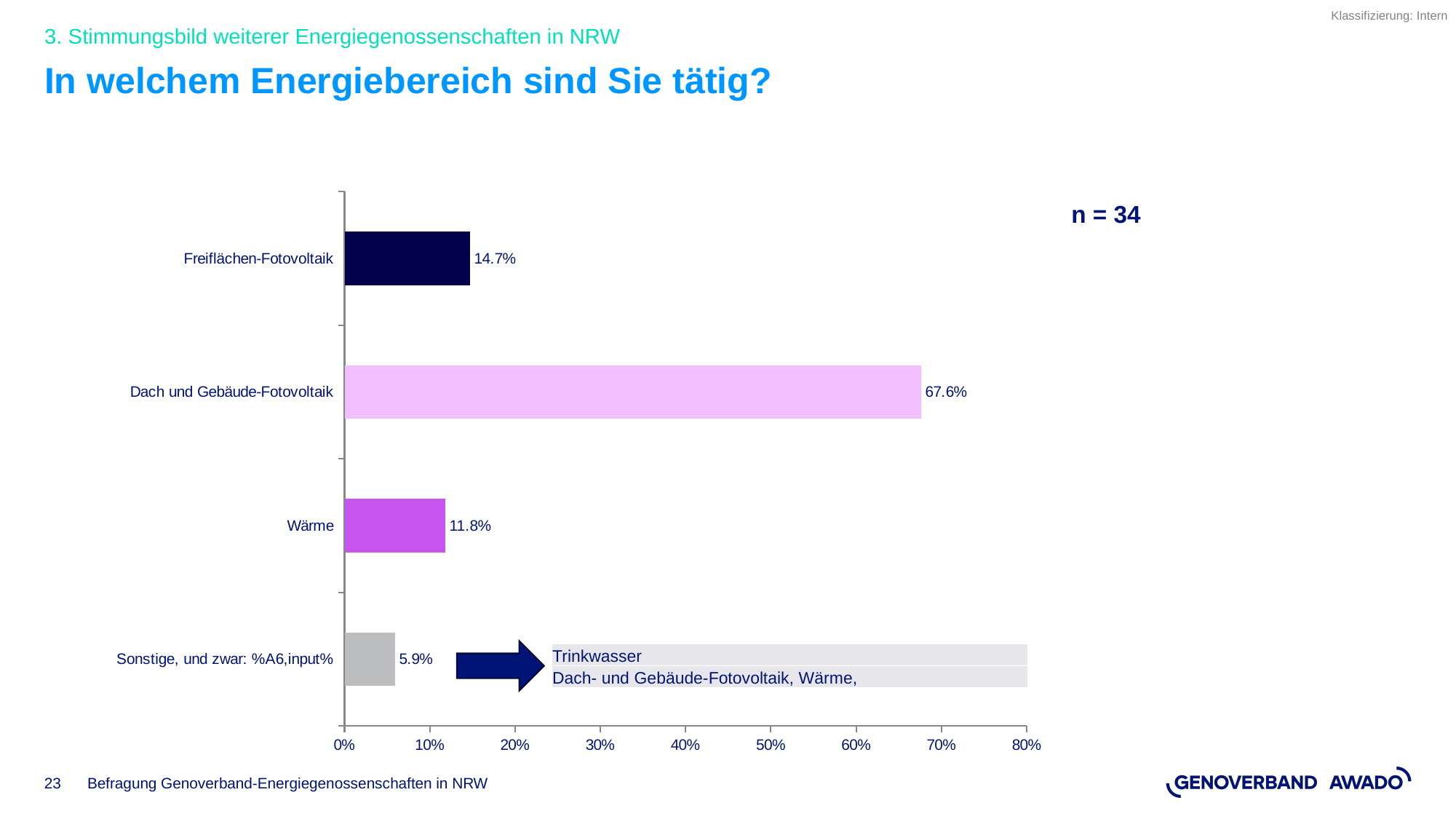
What is the value for Wärme? 11.8% What kind of chart is shown on the slide? Bar chart What is the difference between the values for Dach und Gebäude-Fotovoltaik and Freiflächen-Fotovoltaik? 52.9% How many categories are shown in the chart? 4 What is the value for the Sonstige category? 5.9% Which category has the lowest value? Sonstige, und zwar: %A6,input% What is the value for Dach und Gebäude-Fotovoltaik? 67.6% Which category has the highest value? Dach und Gebäude-Fotovoltaik What sample size (n) is stated next to the chart? n = 34 What is the difference between the values for Freiflächen-Fotovoltaik and Wärme? 2.9% Which is larger, the value for Freiflächen-Fotovoltaik or the value for Wärme? Freiflächen-Fotovoltaik What is the value for Freiflächen-Fotovoltaik? 14.7%